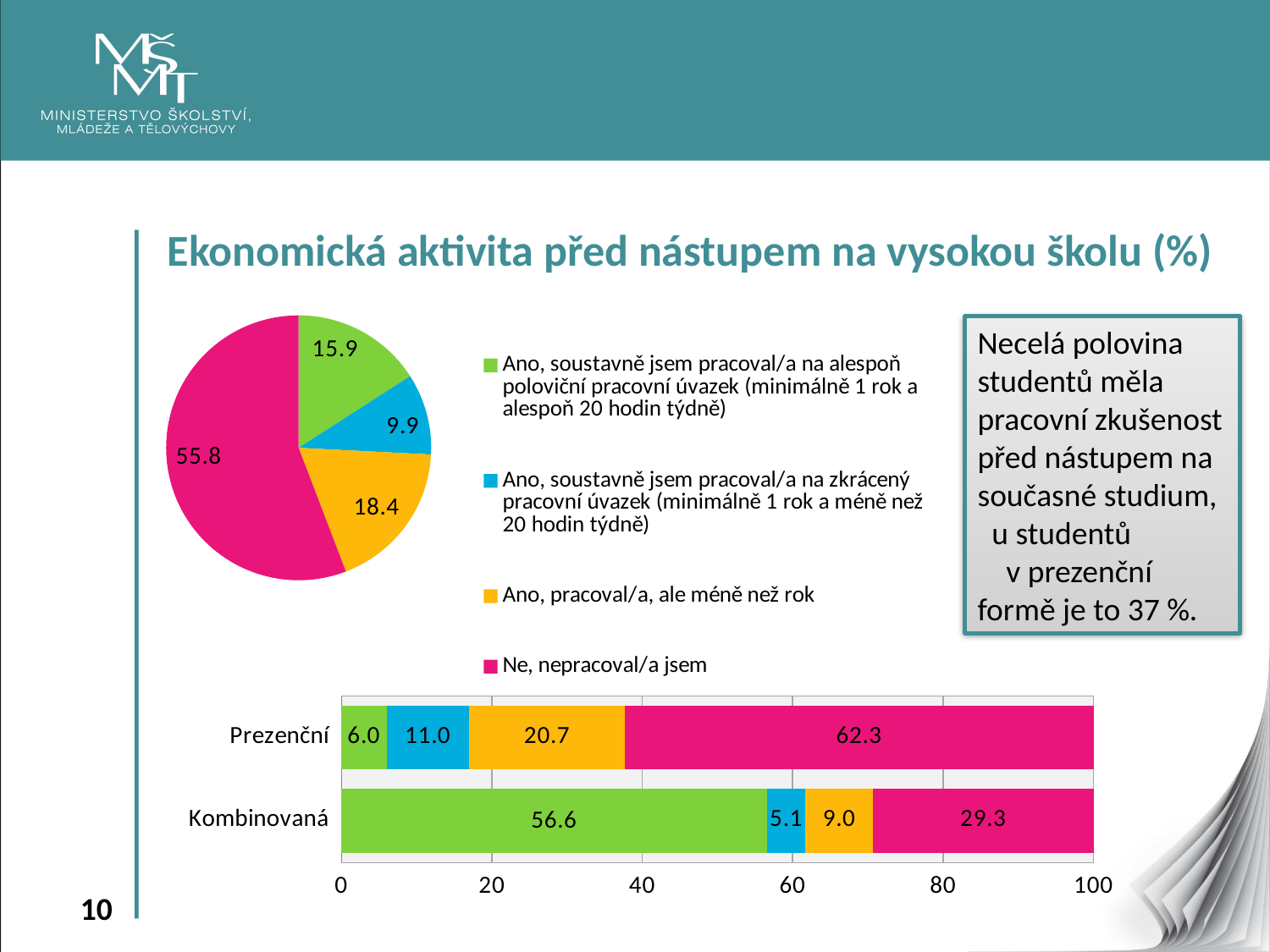
In the stacked bar chart at the bottom of the slide, what is the difference between the orange segments for Prezenční (20.7) and Kombinovaná (9.0)? 11.7 In the stacked bar chart at the bottom of the slide, what is the value of the green segment for Kombinovaná? 56.6 In the pie chart at the top of the slide, what is the difference between the 18.4 slice and the 15.9 slice? 2.5 In the pie chart at the top of the slide, what value is shown for "Ano, pracoval/a, ale méně než rok"? 18.4 In the stacked bar chart at the bottom of the slide, what is the value of the "Ne, nepracoval/a jsem" segment for Prezenční? 62.3 In the pie chart at the top of the slide, how many slices are there? 4 How many series does the legend list? 4 In the stacked bar chart at the bottom of the slide, how many categories are shown on the vertical axis? 2 In the pie chart at the top of the slide, what share is shown for "Ne, nepracoval/a jsem"? 55.8 What type of chart is shown at the bottom of the slide? Stacked bar chart In the stacked bar chart at the bottom of the slide, which form has the larger "Ne, nepracoval/a jsem" segment, Prezenční or Kombinovaná? Prezenční In the pie chart at the top of the slide, which category has the smallest slice? Ano, soustavně jsem pracoval/a na zkrácený pracovní úvazek (minimálně 1 rok a méně než 20 hodin týdně)